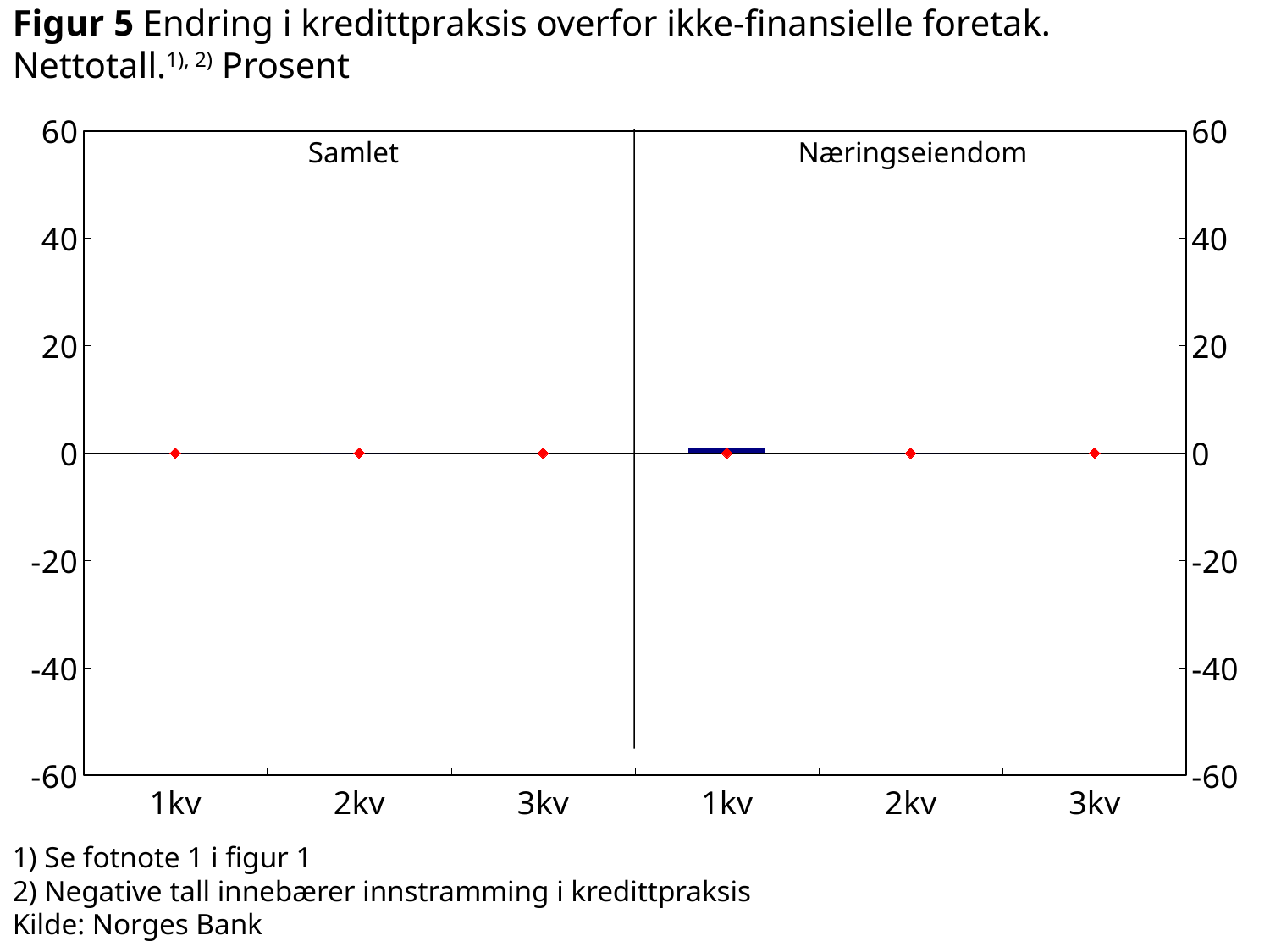
What are the names of the two panels in the chart? Samlet and Næringseiendom Is the value of the blue bar for 1kv in the Næringseiendom panel greater or less than 20? less What is the value of the red diamond marker for 1kv in the Samlet panel? 0 How many quarters are shown on the x axis in the Samlet panel? 3 Is the value of the blue bar for 1kv in the Næringseiendom panel greater or less than -20? greater What is the value of the red diamond marker for 2kv in the Samlet panel? 0 How many quarter categories are shown on the x axis in total across both panels? 6 Is the value of the blue bar for 1kv in the Næringseiendom panel greater or less than 40? less In which panel and quarter does a blue bar appear? Næringseiendom, 1kv What is the value of the red diamond marker for 3kv in the Næringseiendom panel? 0 What is the maximum value shown on the y axis? 60